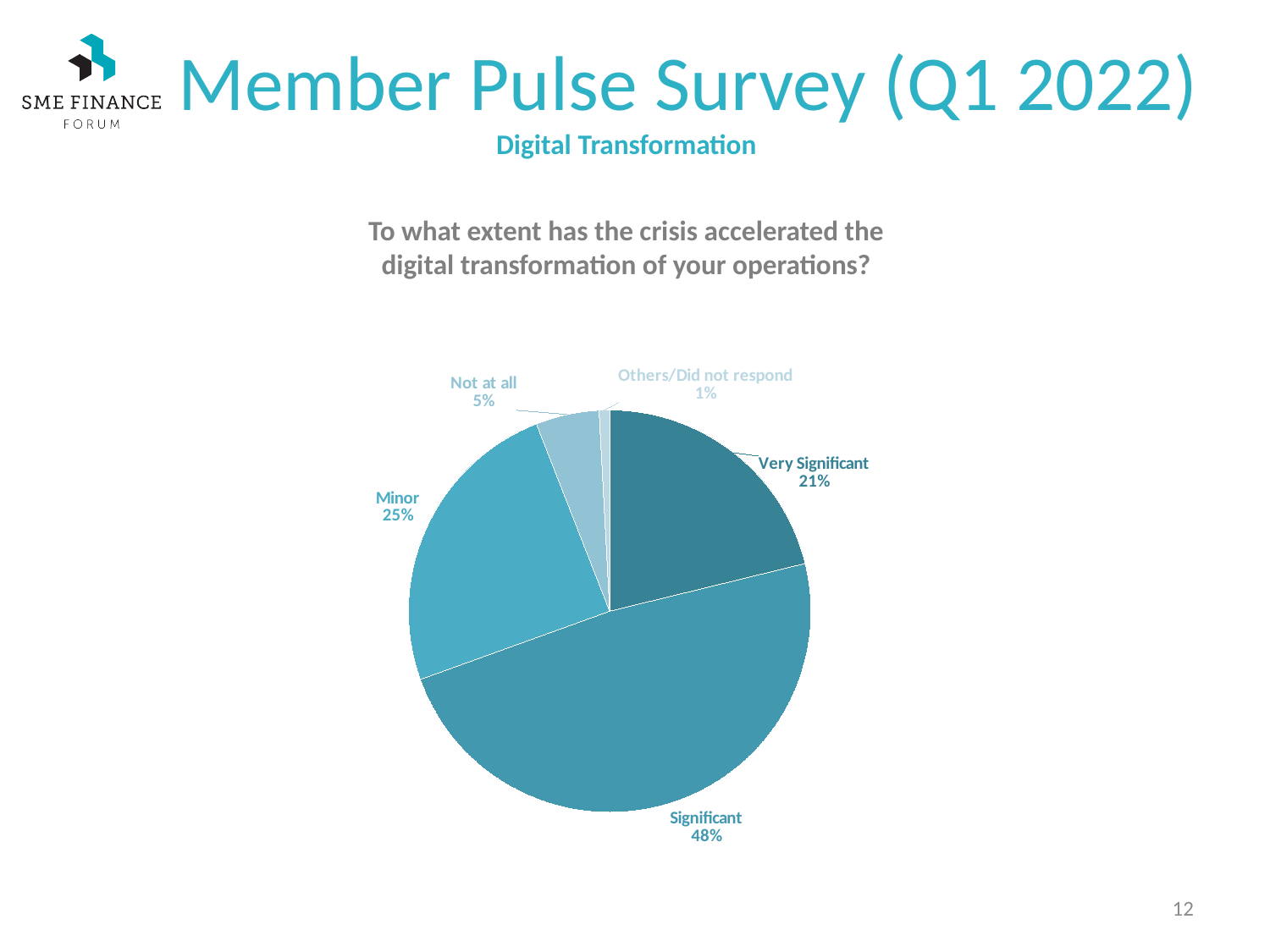
What share of respondents answered "Not at all"? 5% What share of respondents answered "Very Significant"? 21% Which slice is larger, "Minor" or "Very Significant"? Minor Which response category has the largest share of the pie? Significant Which response category has the smallest share of the pie? Others/Did not respond What question does the chart title ask? To what extent has the crisis accelerated the digital transformation of your operations? What share of respondents answered "Significant"? 48% How many slices does the pie chart have? 5 What share of respondents answered "Minor"? 25% What type of chart is shown on the slide? Pie chart What is the difference in percentage points between the "Significant" and "Very Significant" slices? 27 percentage points What share of respondents fall under "Others/Did not respond"? 1%